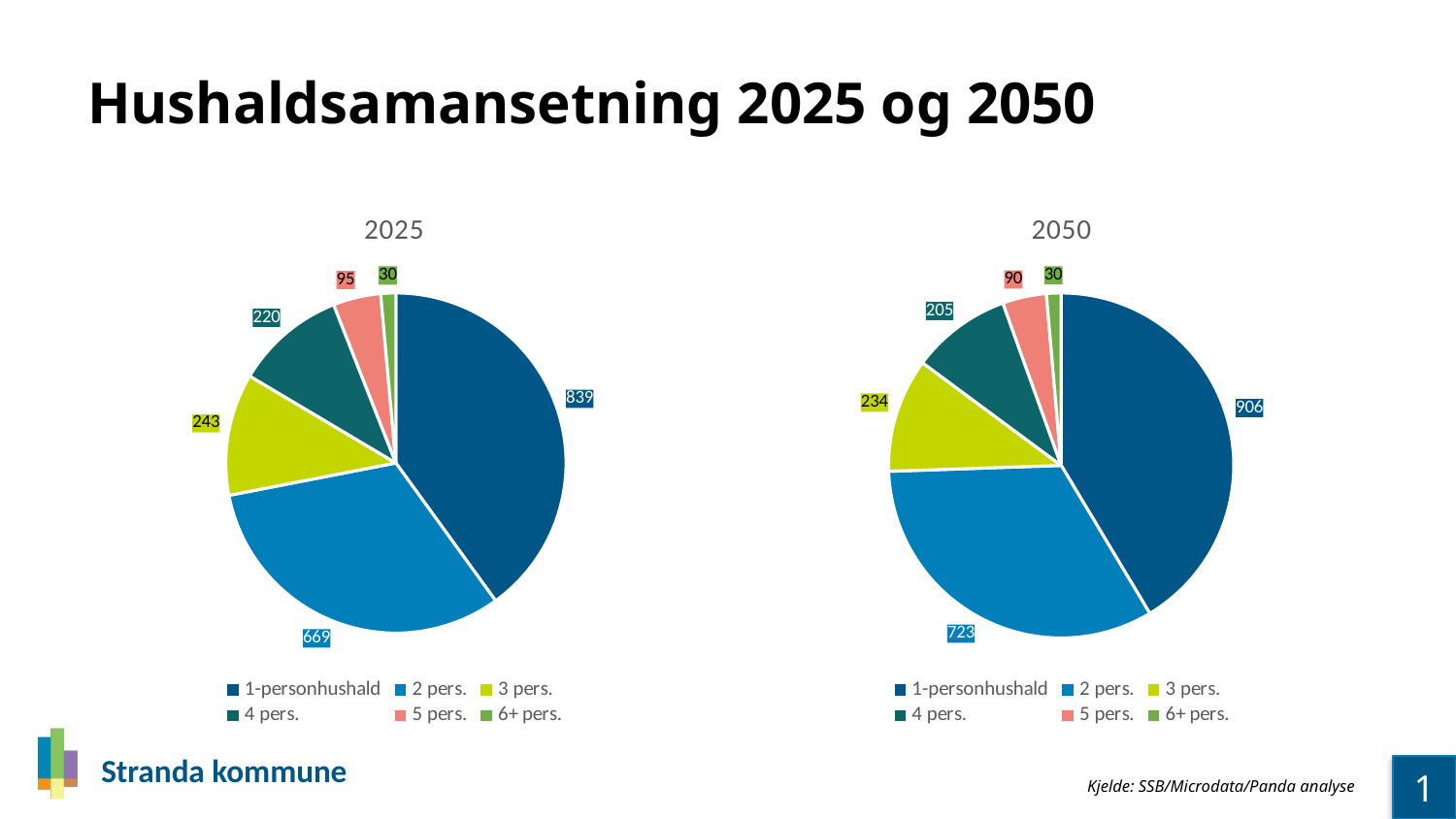
Which is larger: the 5 pers. value in the 2025 chart or in the 2050 chart? 2025 (95) In the 2025 chart, what is the value for 4 pers.? 220 In the 2025 chart, which category has the smallest slice? 6+ pers. In the 2025 chart, what is the value for 1-personhushald? 839 What is the difference between the 1-personhushald value in the 2050 chart and in the 2025 chart? 67 In the 2050 chart, what is the difference between the 3 pers. and 4 pers. values? 29 In the 2050 chart, what is the value for 2 pers.? 723 In the 2050 chart, which category has the largest slice? 1-personhushald What is the total of all slices in the 2025 chart? 2096 What kind of charts are shown on the slide? Pie charts How many slices does the 2025 pie chart have? 6 How many series does the legend of the 2050 chart list? 6